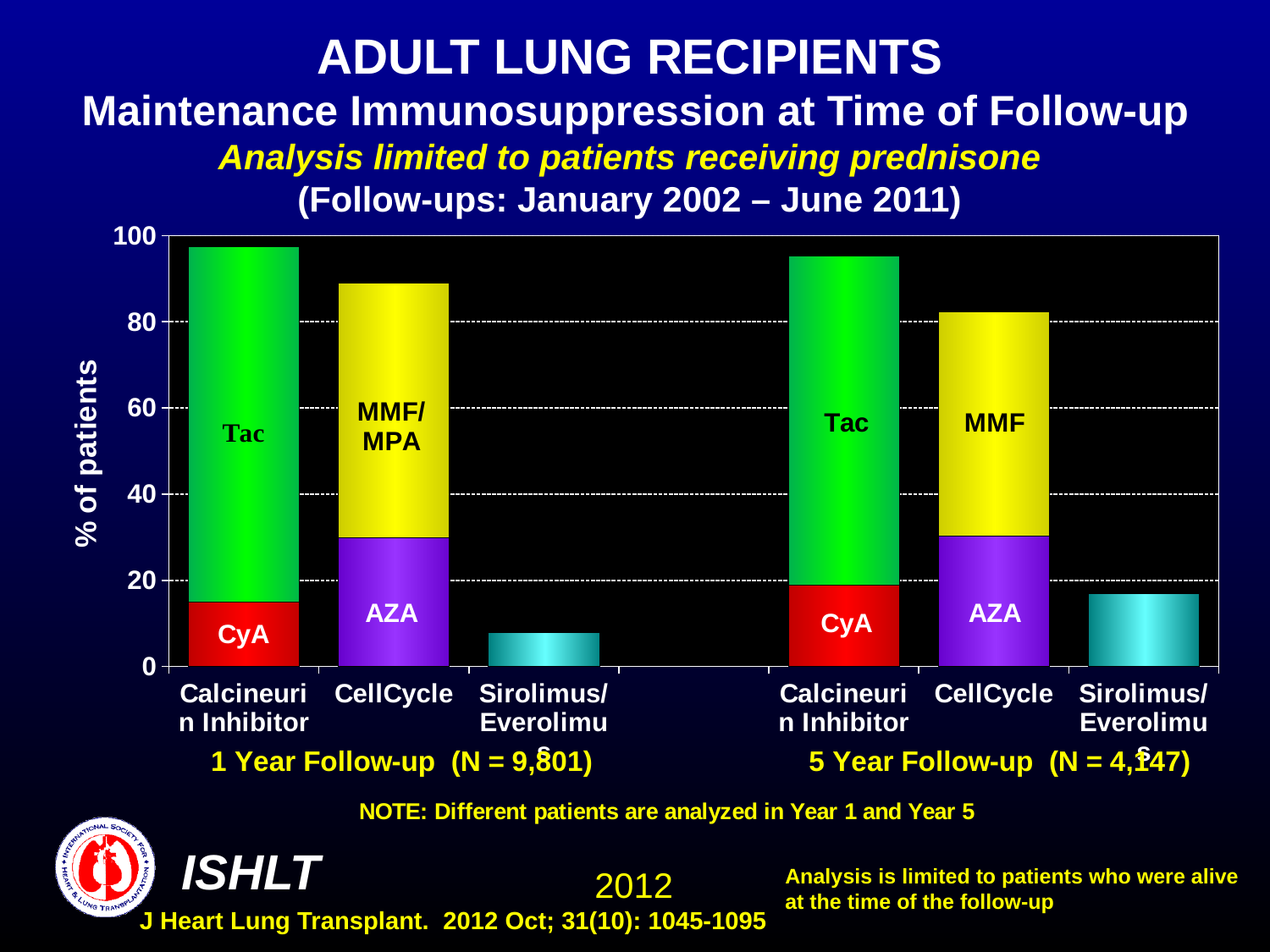
What is the label on the y axis of the chart? % of patients In the 1 Year Follow-up group, is the CyA segment of the Calcineurin Inhibitor bar greater or less than 20? less How many bars are plotted in the 1 Year Follow-up group? 3 Which category has the shortest bar in the 1 Year Follow-up group? Sirolimus/Everolimus In the 5 Year Follow-up group, is the AZA segment of the CellCycle bar greater or less than 40? less In the 5 Year Follow-up group, is the value for Sirolimus/Everolimus greater or less than 20? less What kind of chart is shown on the slide? bar chart Which category has the tallest bar in the 5 Year Follow-up group? Calcineurin Inhibitor Which is larger, the Sirolimus/Everolimus value at 1 Year Follow-up or at 5 Year Follow-up? 5 Year Follow-up